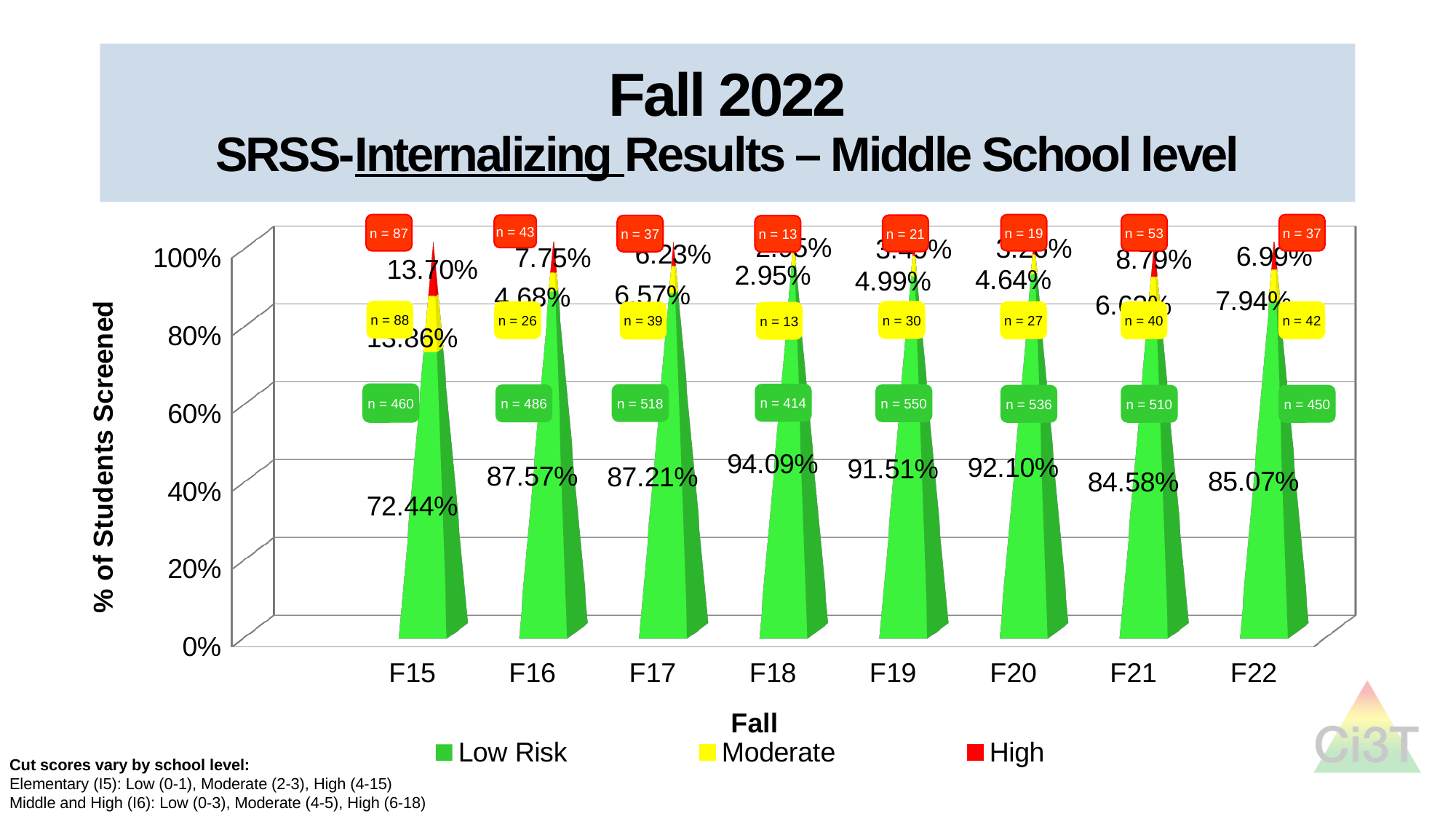
Which fall has the lowest Low Risk percentage? F15 How many fall terms are shown on the x axis? 8 What is the Moderate value for F22? 7.94% What is the High value for F15? 13.70% What is the Low Risk value for F15? 72.44% What is the difference between the Low Risk values for F22 and F21? 0.49% Is the Low Risk value for F16 greater or less than 80%? greater Which has the larger Low Risk value, F19 or F20? F20 Which fall has the highest Low Risk percentage? F18 How many series does the legend list? 3 What kind of chart is shown on the slide? stacked bar chart What is the Low Risk value for F18? 94.09%